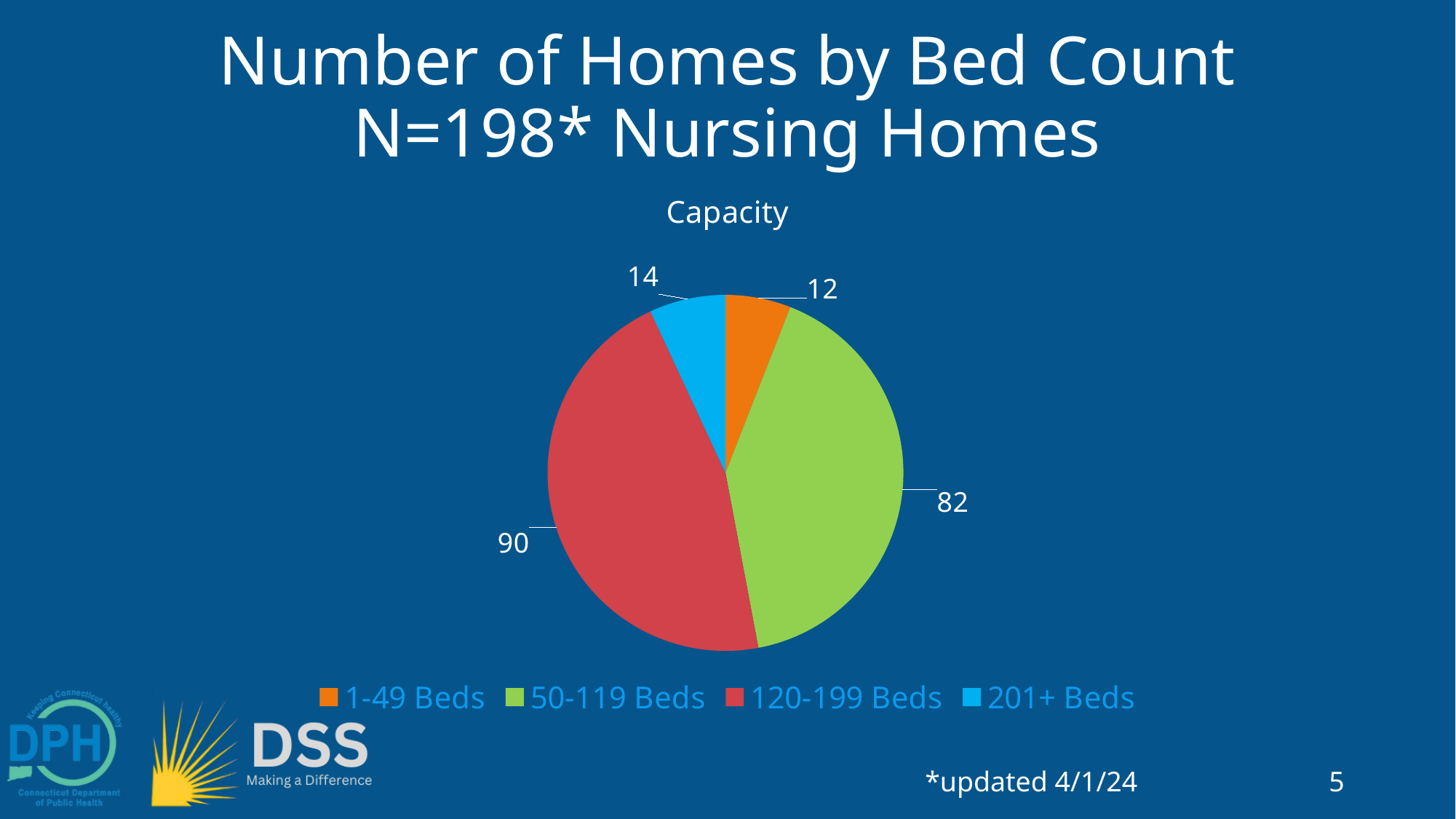
How many homes have 50-119 beds? 82 What colour is the slice for 50-119 Beds? Green How many homes have 120-199 beds? 90 What is the total number of homes across all four slices of the pie? 198 How many homes have 201+ beds? 14 How many homes have 1-49 beds? 12 What is the difference between the number of homes with 120-199 beds and those with 50-119 beds? 8 What type of chart is shown on the slide? Pie chart Which bed-count category has the fewest homes? 1-49 Beds Which bed-count category has the most homes? 120-199 Beds Which has more homes: 201+ Beds or 1-49 Beds? 201+ Beds How many bed-count categories are shown in the pie chart? 4